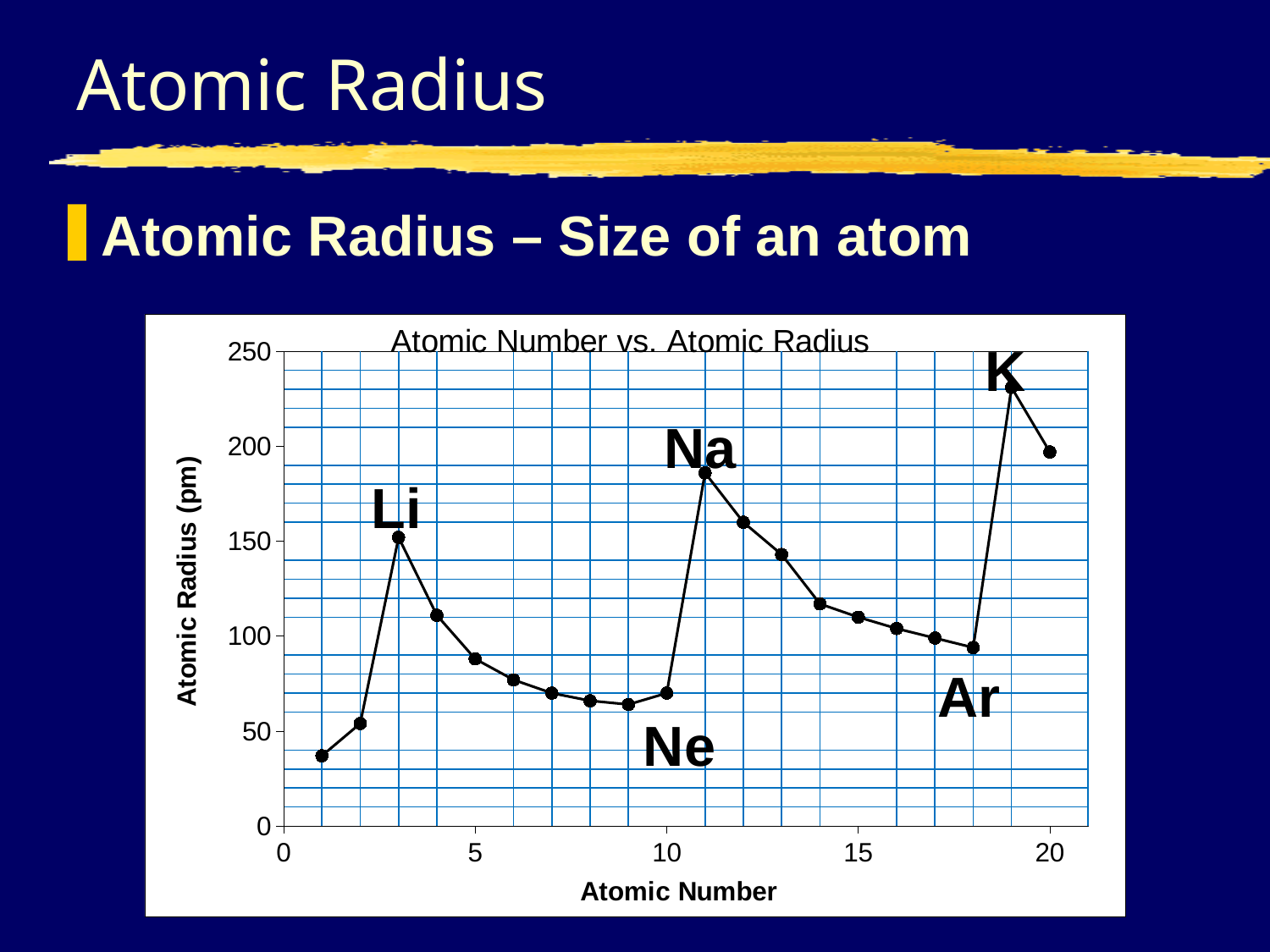
Which has the larger atomic radius, Li or Na? Na Is the atomic radius for Na greater or less than 150? greater What kind of chart is shown on the slide? Line chart Which labelled element has the lowest atomic radius on the chart? Ne How many data points are plotted on the chart? 20 Which labelled element has the highest atomic radius on the chart? K Is the atomic radius at atomic number 1 greater or less than 50? less Do the atomic radius values rise or fall as the atomic number increases from Na to Ar? fall What is the title of the chart? Atomic Number vs. Atomic Radius Is the atomic radius for Ne greater or less than 100? less What is the label of the vertical axis of the chart? Atomic Radius (pm)